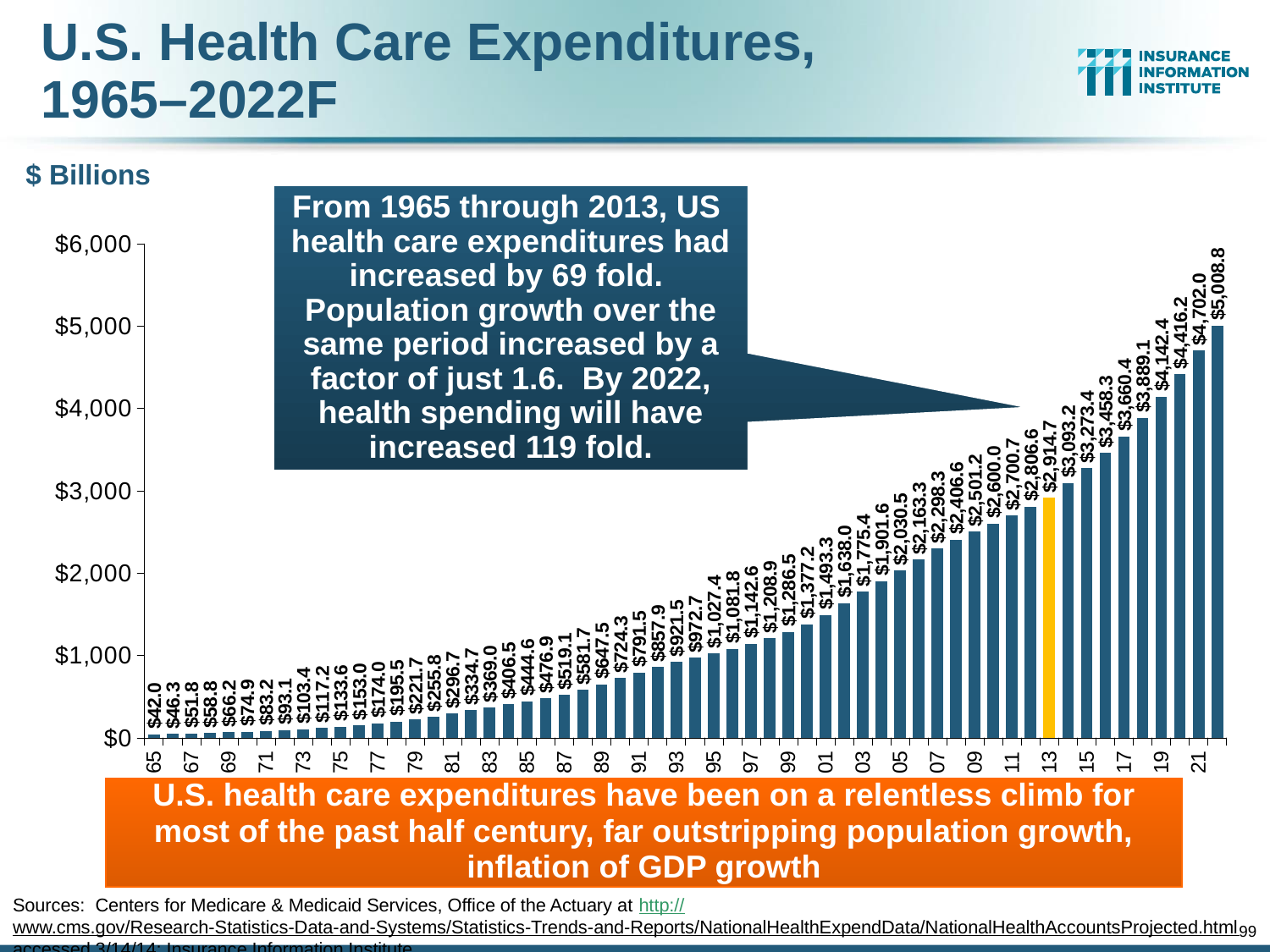
What is the value shown for 2021? $4,702.0 Which year has the highest health care expenditure in the chart? 2022F What colour is the bar for 2013, which is highlighted differently from the others? orange Do the values generally rise or fall from 1965 to 2022F? rise What type of chart is shown on the slide? bar chart What is the difference between the 2022F value ($5,008.8) and the 2013 value ($2,914.7)? $2,094.1 What is the value of the orange-highlighted bar (2013)? $2,914.7 What unit is stated for the values in the chart? $ Billions Which year has the lowest health care expenditure in the chart? 1965 Which is larger, the value for 2021 or the value for 2013? 2021 What is the value of U.S. health care expenditures for 1965 (the first bar)? $42.0 What is the value of the last bar (2022F) in the chart? $5,008.8